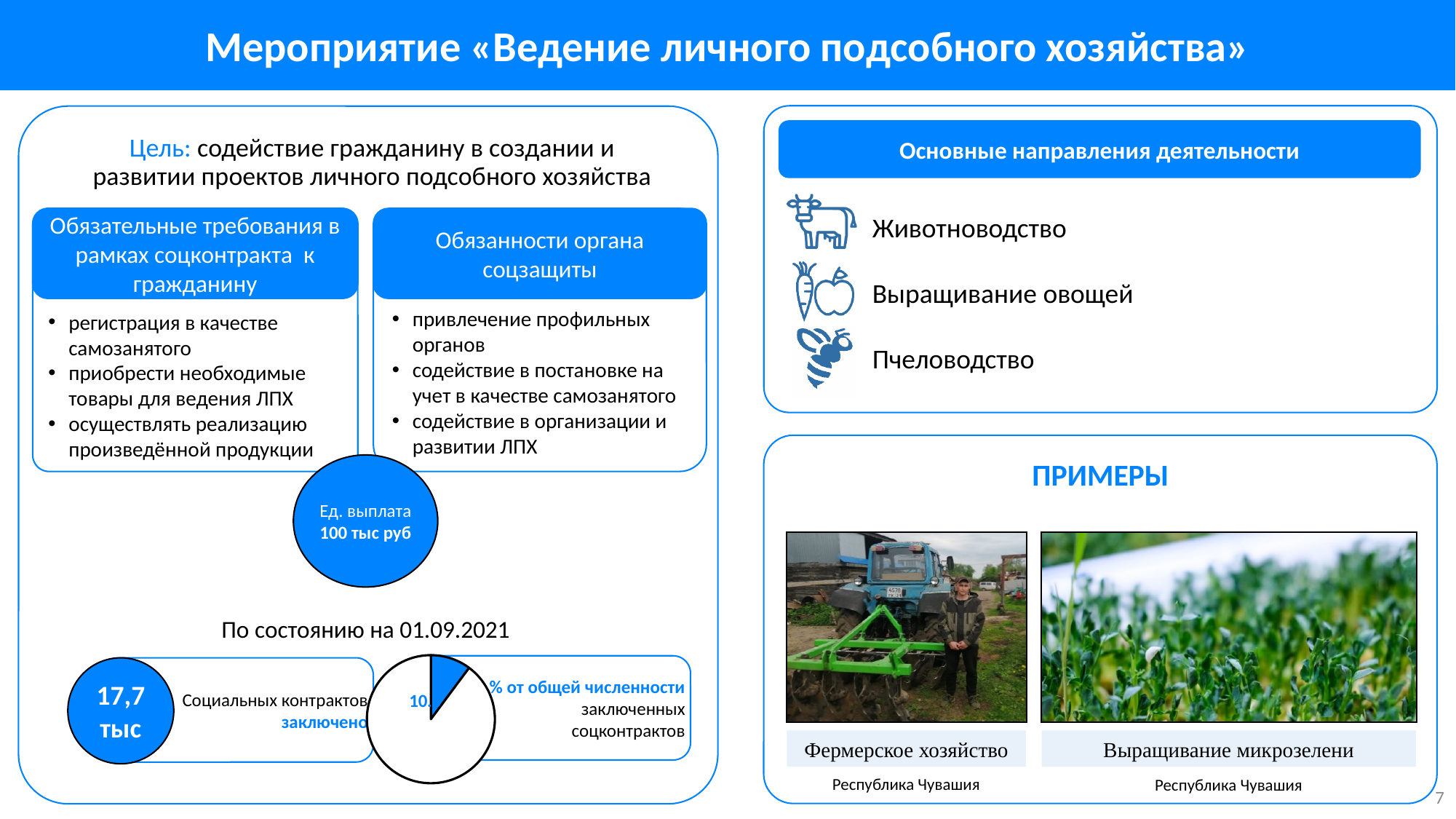
In the pie chart at the bottom left of the slide, which slice is larger, the blue one or the white one? the white one Does the blue slice in the pie chart at the bottom left of the slide represent more or less than half of the pie? less What kind of chart is shown at the bottom left of the slide, next to the text '% от общей численности заключенных соцконтрактов'? pie chart In the pie chart at the bottom left of the slide, what colour is the smaller slice? blue How many slices does the pie chart at the bottom left of the slide have? 2 According to the text next to the pie chart at the bottom left, what does the pie chart show a share of? от общей численности заключенных соцконтрактов